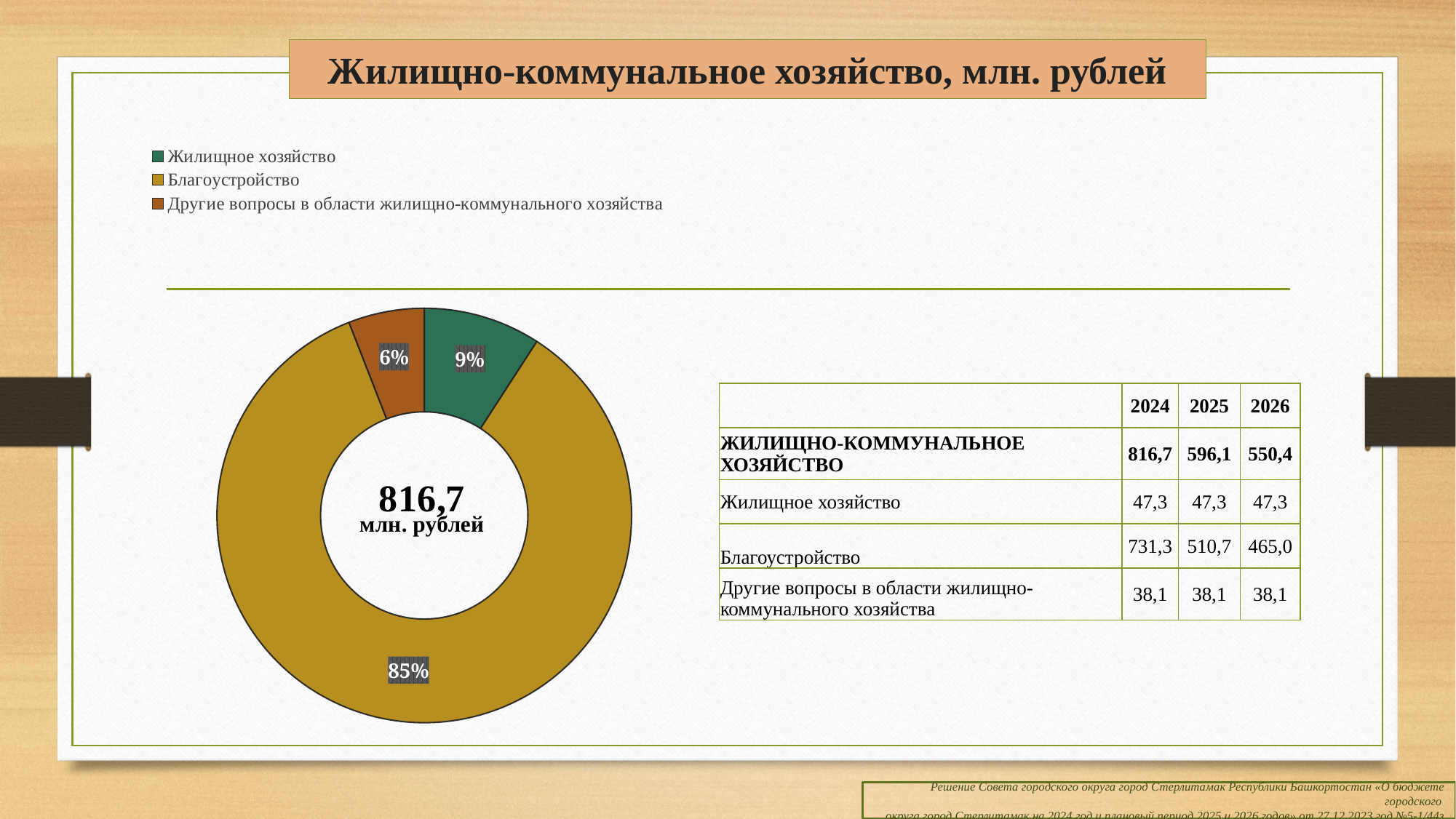
Which category has the smallest slice in the chart? Другие вопросы в области жилищно-коммунального хозяйства What total value is shown in the centre of the doughnut chart? 816,7 млн. рублей What is the difference in percentage points between the Благоустройство slice and the Жилищное хозяйство slice? 76 percentage points What percentage share does the Жилищное хозяйство slice have in the chart? 9% Which slice is larger in the chart: Жилищное хозяйство or Другие вопросы в области жилищно-коммунального хозяйства? Жилищное хозяйство What colour is the Благоустройство slice in the chart? Gold (yellow-brown) What kind of chart is shown on the slide? Doughnut (pie) chart What percentage share does the Благоустройство slice have in the chart? 85% Which category has the largest slice in the chart? Благоустройство How many entries does the chart legend list? 3 What percentage share does the slice for Другие вопросы в области жилищно-коммунального хозяйства have in the chart? 6% How many slices does the doughnut chart have? 3